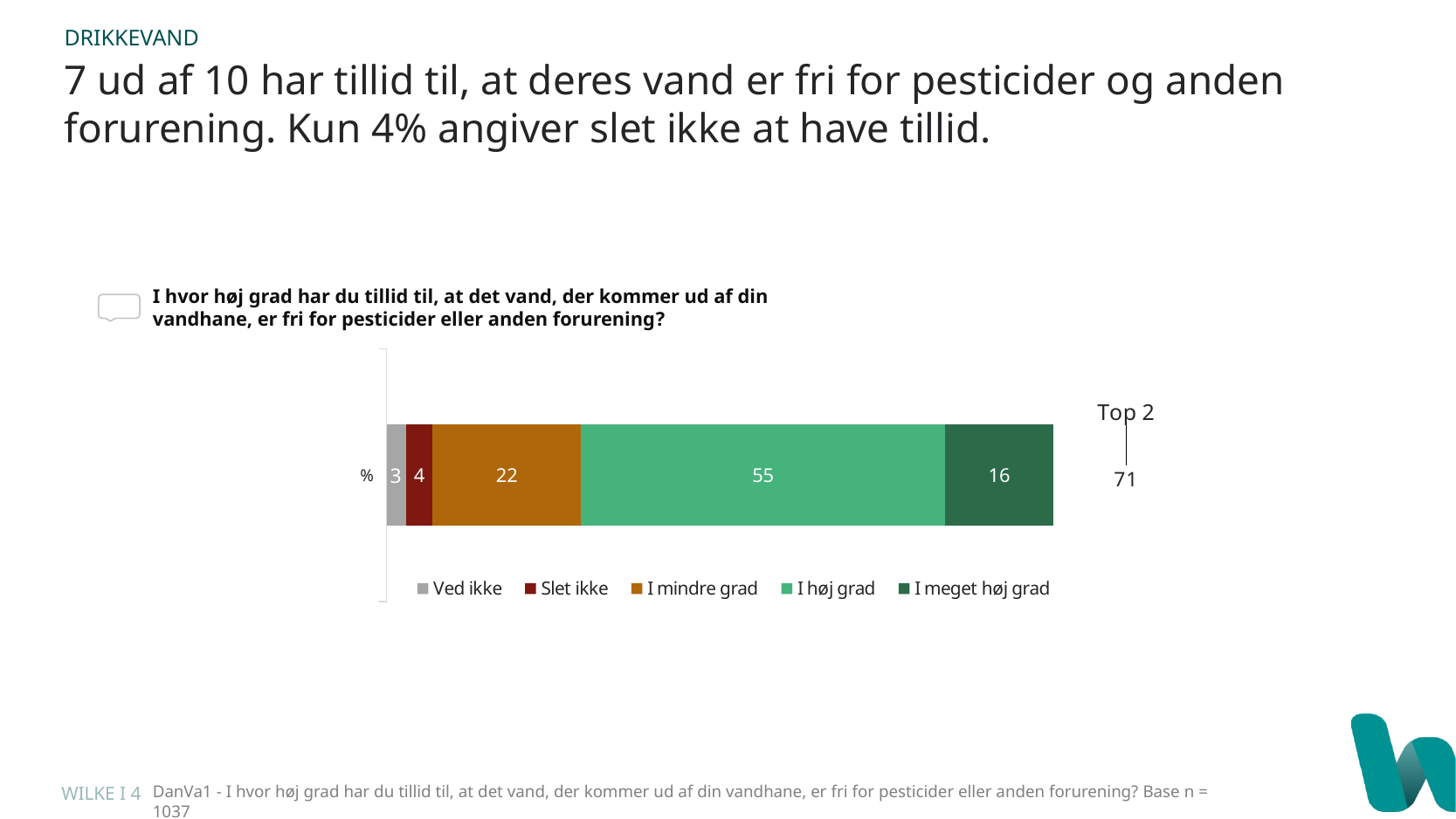
What is the "Top 2" value shown next to the bar? 71 Which response category has the lowest value? Ved ikke What is the total of the "I høj grad" and "I meget høj grad" segments? 71 What value is shown for "Ved ikke"? 3 What kind of chart is shown on the slide? Stacked bar chart What value is shown for "I mindre grad"? 22 Which response category has the highest value? I høj grad What value is shown for "Slet ikke"? 4 How many series does the legend list? 5 Which is larger, the value for "I meget høj grad" or the value for "I mindre grad"? I mindre grad What percentage of respondents answered "I høj grad"? 55 What is the difference between the values for "I høj grad" and "I mindre grad"? 33